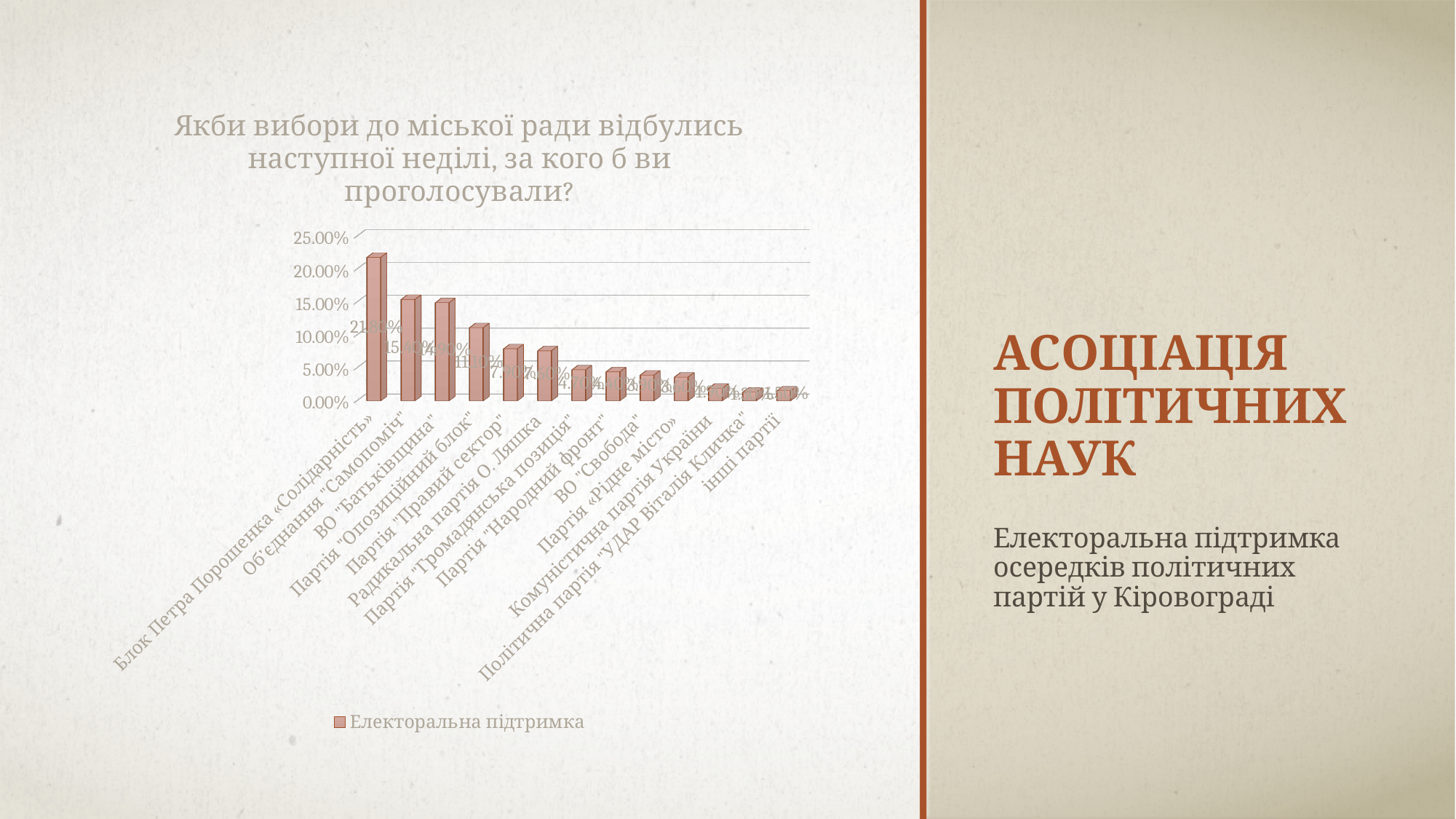
Which has a larger value: Об'єднання "Самопоміч" or Партія "Правий сектор"? Об'єднання "Самопоміч" Which party has the highest electoral support in the chart? Блок Петра Порошенка «Солідарність» How many parties (categories) are shown on the x axis of the chart? 13 Is the value for ВО "Батьківщина" greater or less than 10.00%? greater What is the value shown for Об'єднання "Самопоміч"? 15.40% What is the name of the series listed in the chart legend? Електоральна підтримка What is the value shown for Блок Петра Порошенка «Солідарність»? 21.80% Do the values rise or fall moving from left to right along the x axis? fall How many series does the chart legend list? 1 Is the value for Партія "Правий сектор" greater or less than 10.00%? less What kind of chart is shown on the slide? bar chart What is the difference between the values for Блок Петра Порошенка «Солідарність» and Об'єднання "Самопоміч"? 6.40%